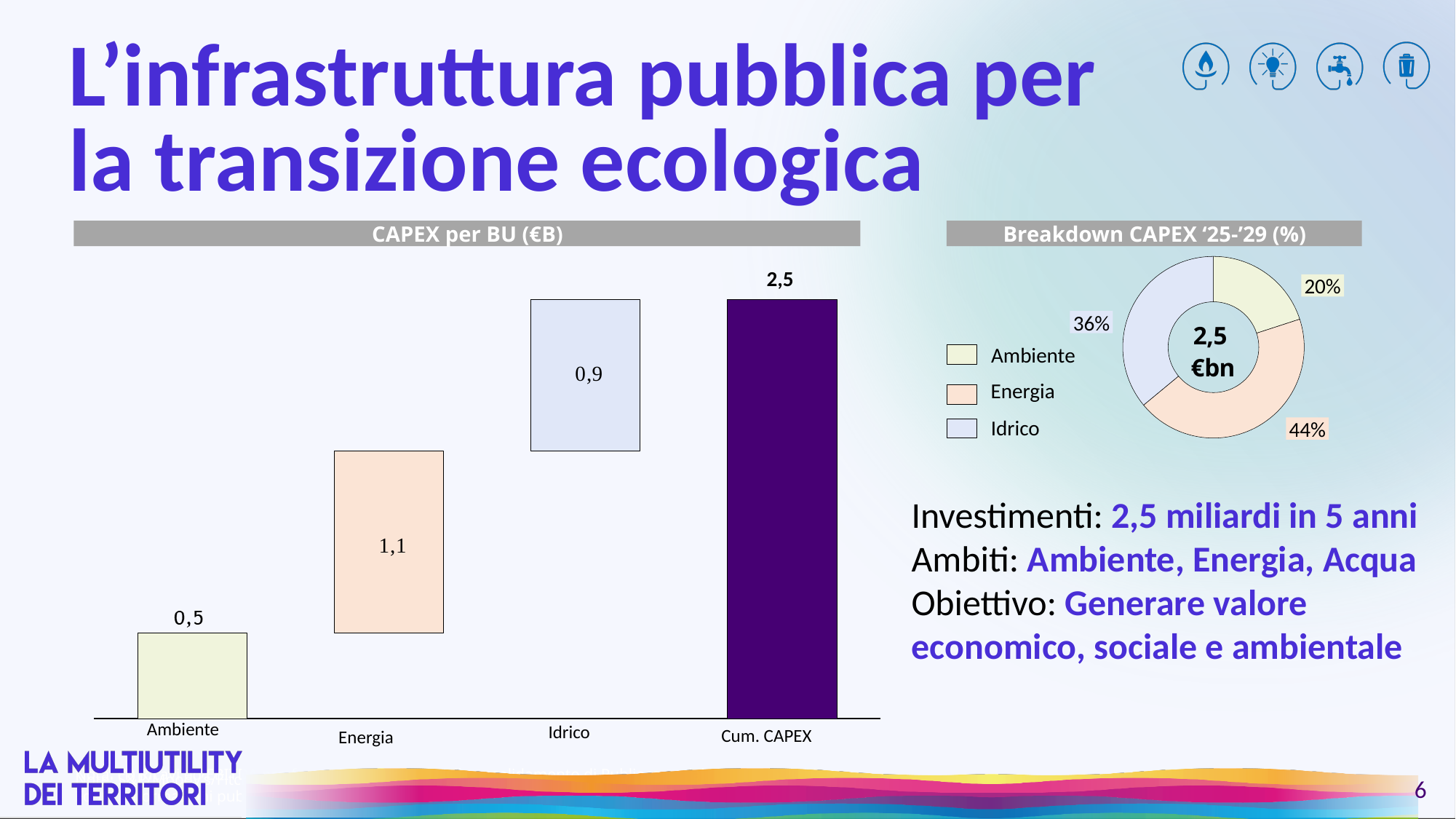
In the 'CAPEX per BU (€B)' chart, what is the value for Ambiente? 0,5 In the 'CAPEX per BU (€B)' chart, which category has the lowest value? Ambiente In the 'CAPEX per BU (€B)' chart, what is the value for Energia? 1,1 How many categories are shown on the x axis of the 'CAPEX per BU (€B)' chart? 4 In the 'Breakdown CAPEX '25-'29 (%)' chart, which segment is the smallest? Ambiente In the 'CAPEX per BU (€B)' chart, which business unit (excluding Cum. CAPEX) has the highest value? Energia What kind of chart is 'CAPEX per BU (€B)'? Bar chart In the 'CAPEX per BU (€B)' chart, what is the value for Cum. CAPEX? 2,5 In the 'CAPEX per BU (€B)' chart, what is the difference between the Energia and Idrico values? 0,2 In the 'Breakdown CAPEX '25-'29 (%)' chart, what share does Energia have? 44% How many entries does the legend of the 'Breakdown CAPEX '25-'29 (%)' chart list? 3 In the 'CAPEX per BU (€B)' chart, which is larger, Idrico or Ambiente? Idrico